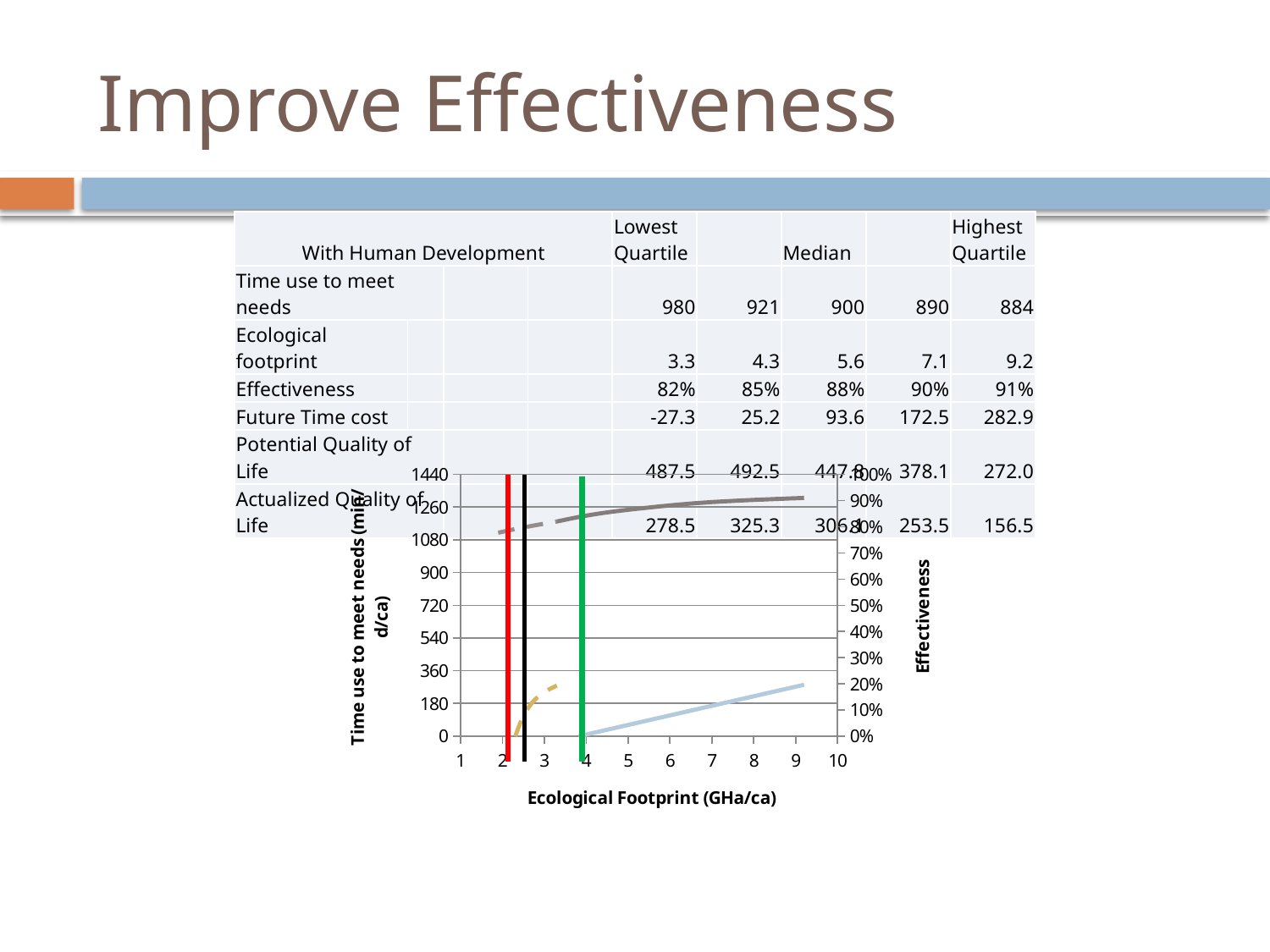
Does the thick grey line rise or fall as Ecological Footprint increases along the x axis? rises Does the light blue line rise or fall as Ecological Footprint increases along the x axis? rises Is the value of the light blue line at an Ecological Footprint of 9 greater or less than 360 on the left axis? less How many tick values are labelled on the x axis of the chart? 10 What kind of chart is shown on the slide? line chart Is the value of the thick grey line at an Ecological Footprint of 2 greater or less than 90% on the right axis? less Is the value of the thick grey line at an Ecological Footprint of 9 greater or less than 80% on the right axis? greater What is the title of the x axis of the chart? Ecological Footprint (GHa/ca) What is the title of the right-hand y axis of the chart? Effectiveness